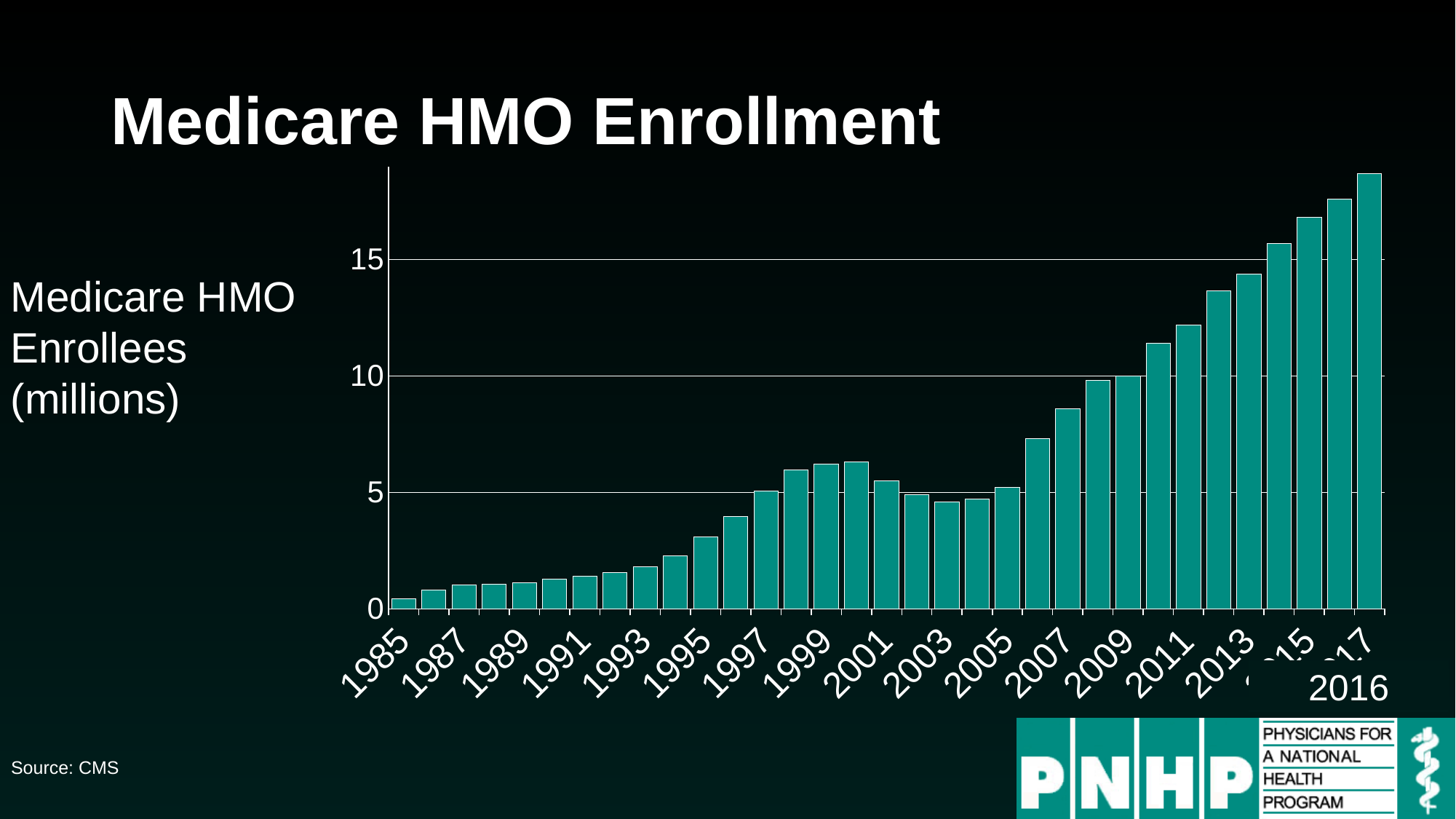
Do the values generally rise or fall from 1985 to 2017? rise Is the value for 1985 greater or less than 5? less Is the value for 2017 greater or less than 15? greater Which year has the lowest Medicare HMO enrollment? 1985 Do the values rise or fall from 1999 to 2003? fall Is the value for 1995 greater or less than 5? less Which year has the highest Medicare HMO enrollment? 2017 What kind of chart is shown on the slide? bar chart What is the unit given for the y axis of the chart? millions Which year has the larger enrollment, 2011 or 2001? 2011